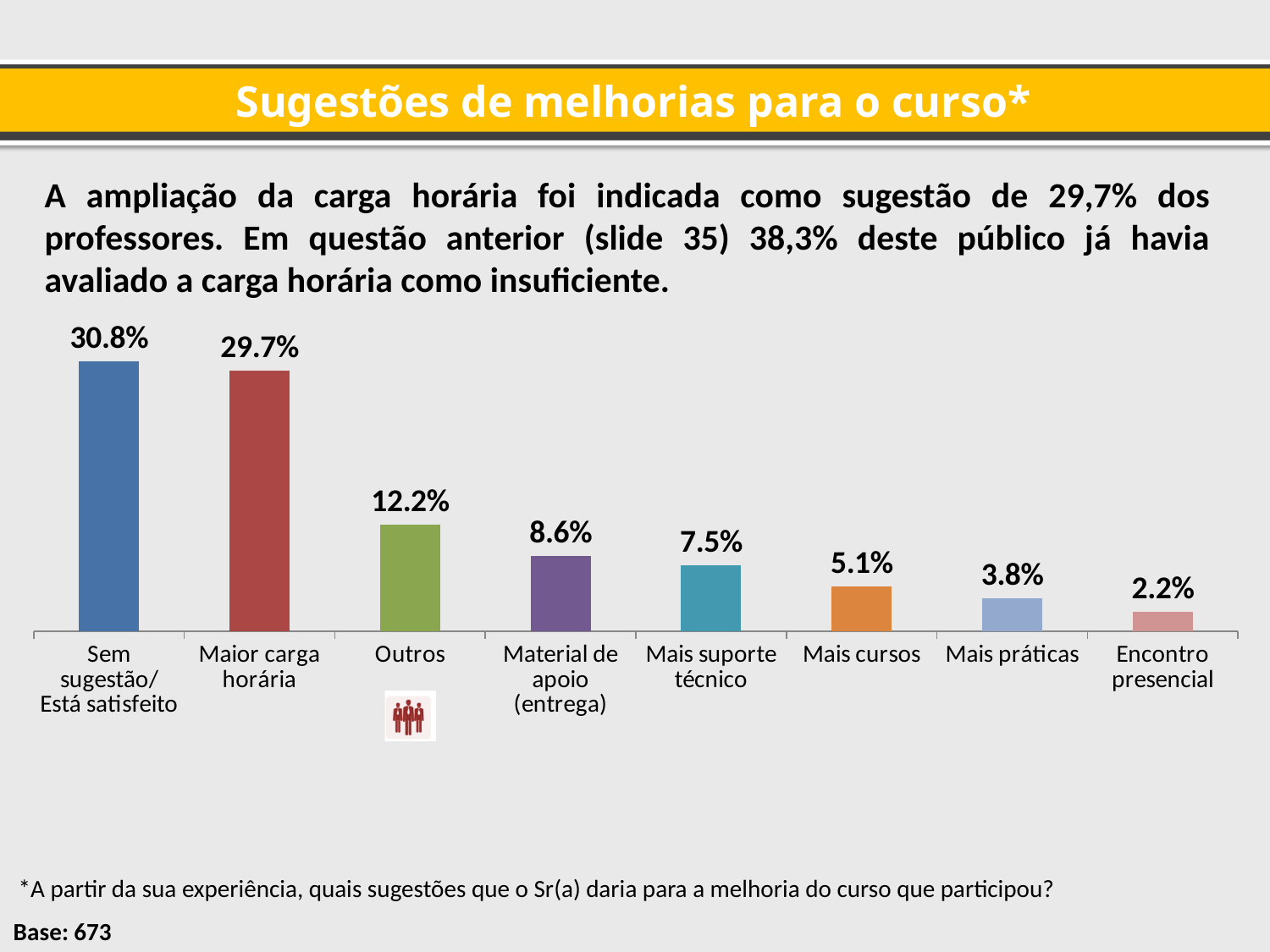
What is the value for "Material de apoio (entrega)"? 8.6% How many categories are shown in the chart? 8 What is the difference between the values for "Outros" and "Mais cursos"? 7.1% Which category has the lowest value? Encontro presencial What is the value for "Encontro presencial"? 2.2% Do the values rise or fall from left to right along the x axis? Fall Which is larger, the value for "Mais cursos" or the value for "Mais práticas"? Mais cursos Which category has the highest value? Sem sugestão/ Está satisfeito What is the value for "Mais suporte técnico"? 7.5% What kind of chart is shown on the slide? Bar chart What is the value for "Maior carga horária"? 29.7% What is the title of the slide containing the chart? Sugestões de melhorias para o curso*